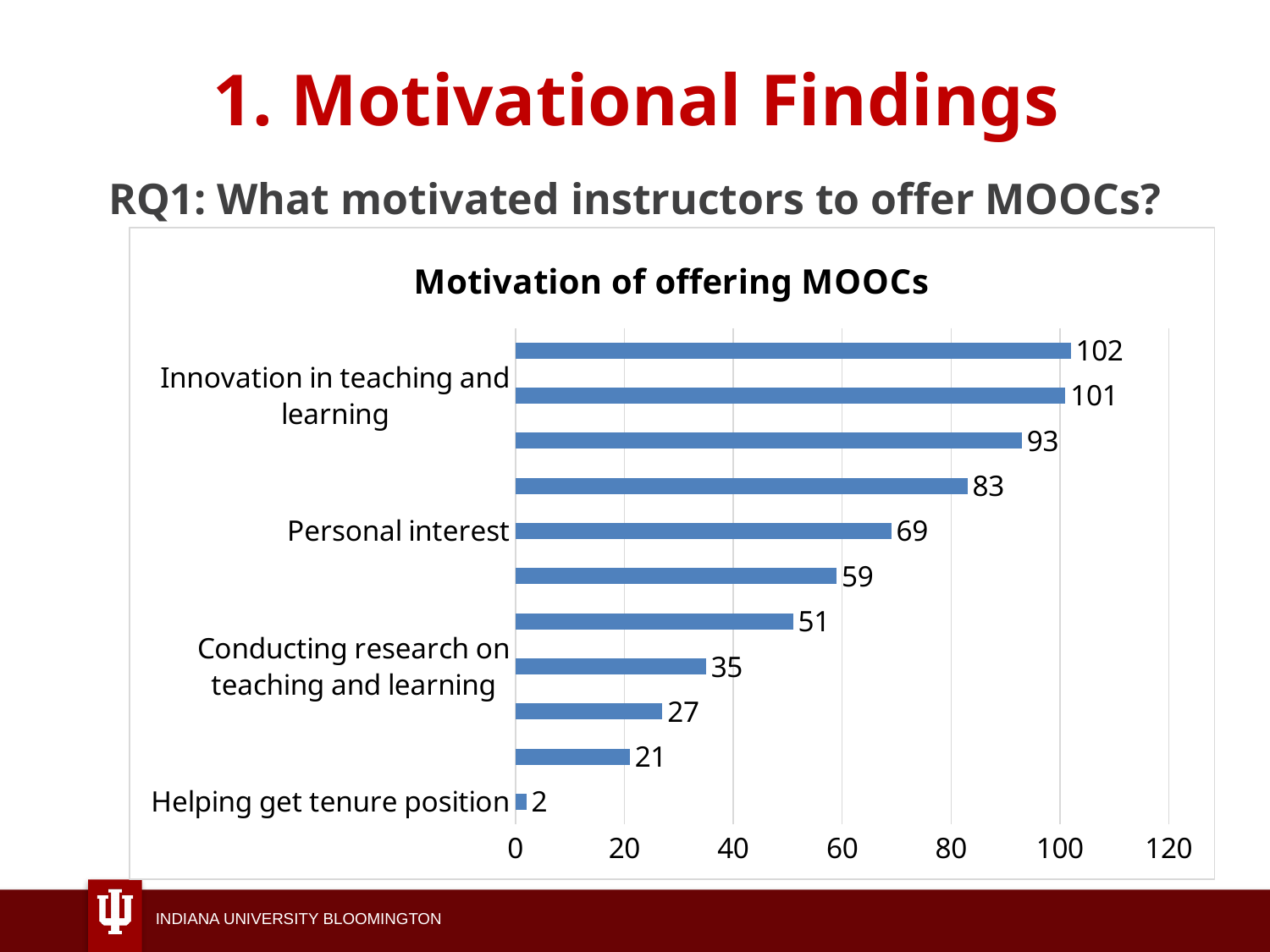
Which labeled category has the lowest value? Helping get tenure position What kind of chart is shown on the slide? Bar chart What is the value for Innovation in teaching and learning? 101 What is the difference between the values for Personal interest and Conducting research on teaching and learning? 34 Which labeled category has the highest value? Innovation in teaching and learning What is the value for Conducting research on teaching and learning? 35 Which is larger, the value for Personal interest or the value for Conducting research on teaching and learning? Personal interest What is the value for Personal interest? 69 What is the value for Helping get tenure position? 2 What is the difference between the values for Innovation in teaching and learning and Personal interest? 32 How many bars are plotted in the chart? 11 What is the title of the chart? Motivation of offering MOOCs